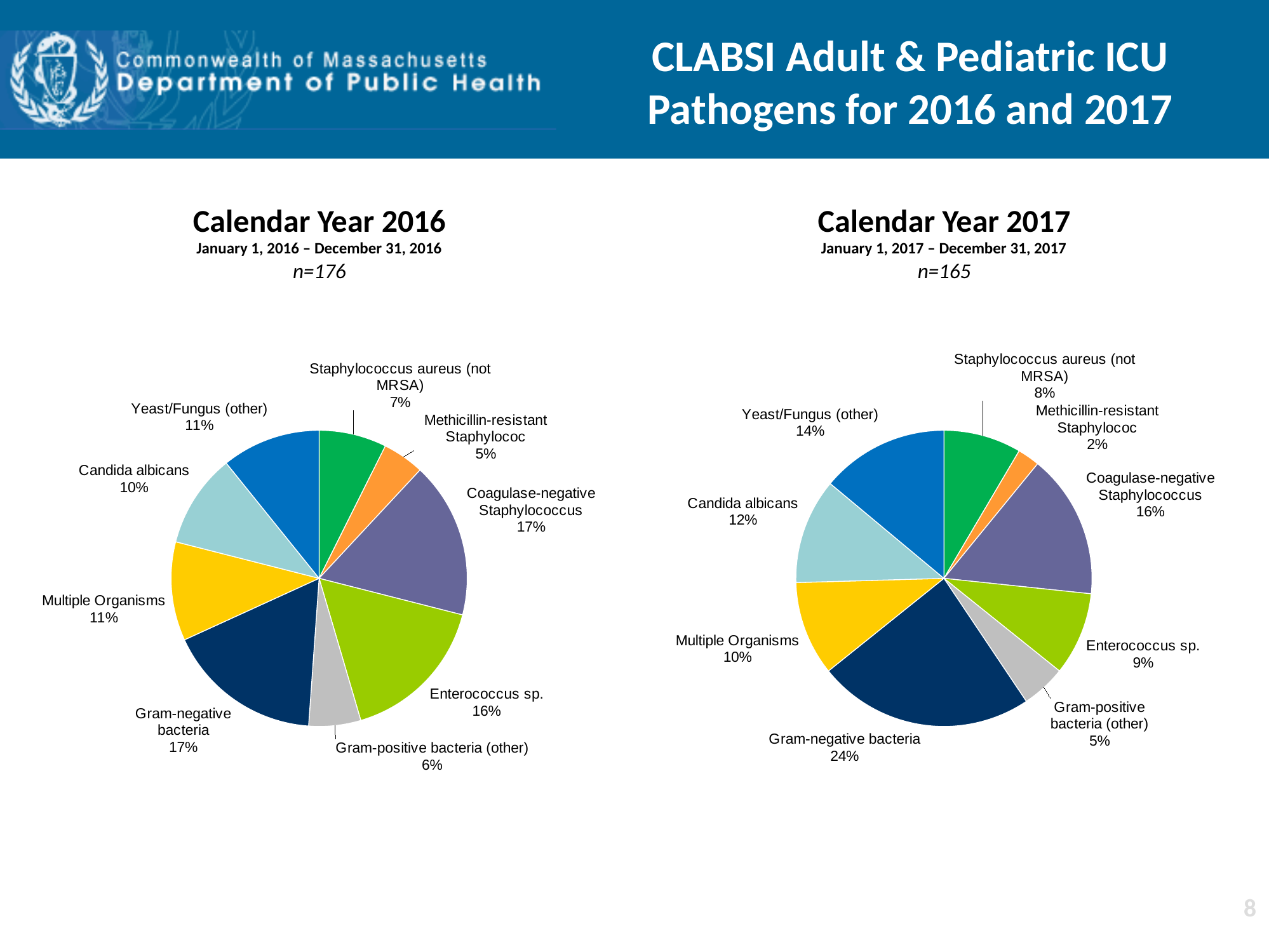
In the Calendar Year 2016 pie chart, what percentage is Candida albicans? 10% In the Calendar Year 2017 pie chart, what percentage is Gram-negative bacteria? 24% What is the difference in percentage points between Gram-negative bacteria in the Calendar Year 2017 chart and Gram-negative bacteria in the Calendar Year 2016 chart? 7 In the Calendar Year 2017 pie chart, which pathogen category has the smallest share? Methicillin-resistant Staphylococ What type of chart is used for Calendar Year 2016? Pie chart How many slices does the Calendar Year 2017 pie chart have? 9 In the Calendar Year 2017 pie chart, which pathogen category has the largest share? Gram-negative bacteria In the Calendar Year 2016 pie chart, what percentage is Enterococcus sp.? 16% What is the n value shown for the Calendar Year 2017 chart? n=165 In the Calendar Year 2016 pie chart, which is larger: Enterococcus sp. or Multiple Organisms? Enterococcus sp. In the Calendar Year 2017 pie chart, what percentage is Yeast/Fungus (other)? 14% In the Calendar Year 2016 pie chart, which pathogen category has the smallest share? Methicillin-resistant Staphylococ